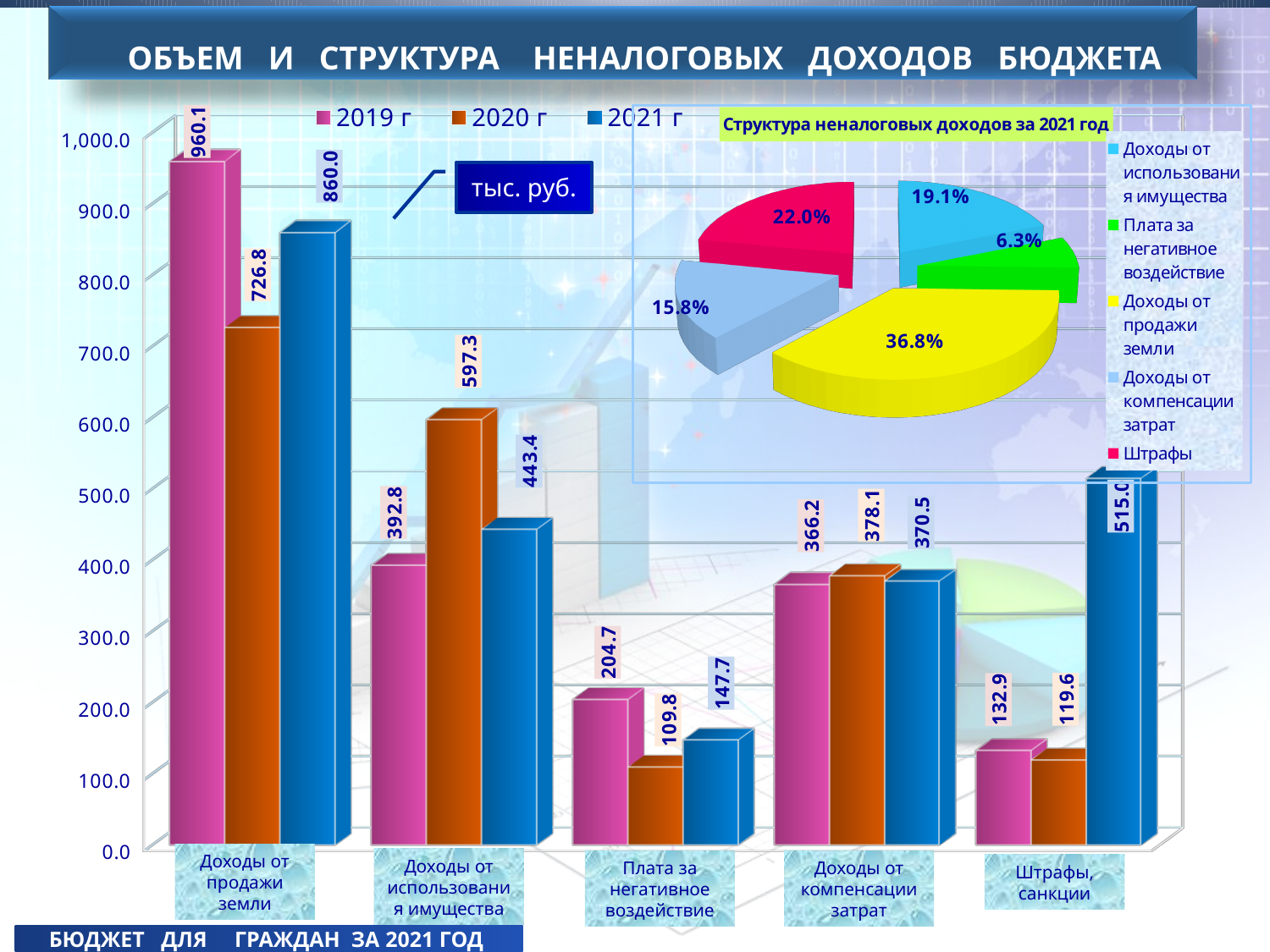
How many categories are shown on the x axis of the bar chart? 5 In the pie chart Структура неналоговых доходов за 2021 год, which category has the smallest share? Плата за негативное воздействие What unit is shown in the callout box on the bar chart? тыс. руб. In the bar chart, what is the 2021 value for Плата за негативное воздействие? 147.7 In the pie chart Структура неналоговых доходов за 2021 год, what share does Доходы от продажи земли have? 36.8% In the bar chart, which category has the highest 2019 value? Доходы от продажи земли In the bar chart, what is the 2020 value for Доходы от использования имущества? 597.3 In the bar chart, which is larger for Доходы от компенсации затрат: the 2020 value or the 2019 value? 2020 In the bar chart, what is the difference between the 2019 and 2020 values for Доходы от продажи земли? 233.3 In the bar chart, what is the 2019 value for Доходы от продажи земли? 960.1 In the bar chart, which category has the lowest 2020 value? Плата за негативное воздействие How many series does the bar chart legend list? 3